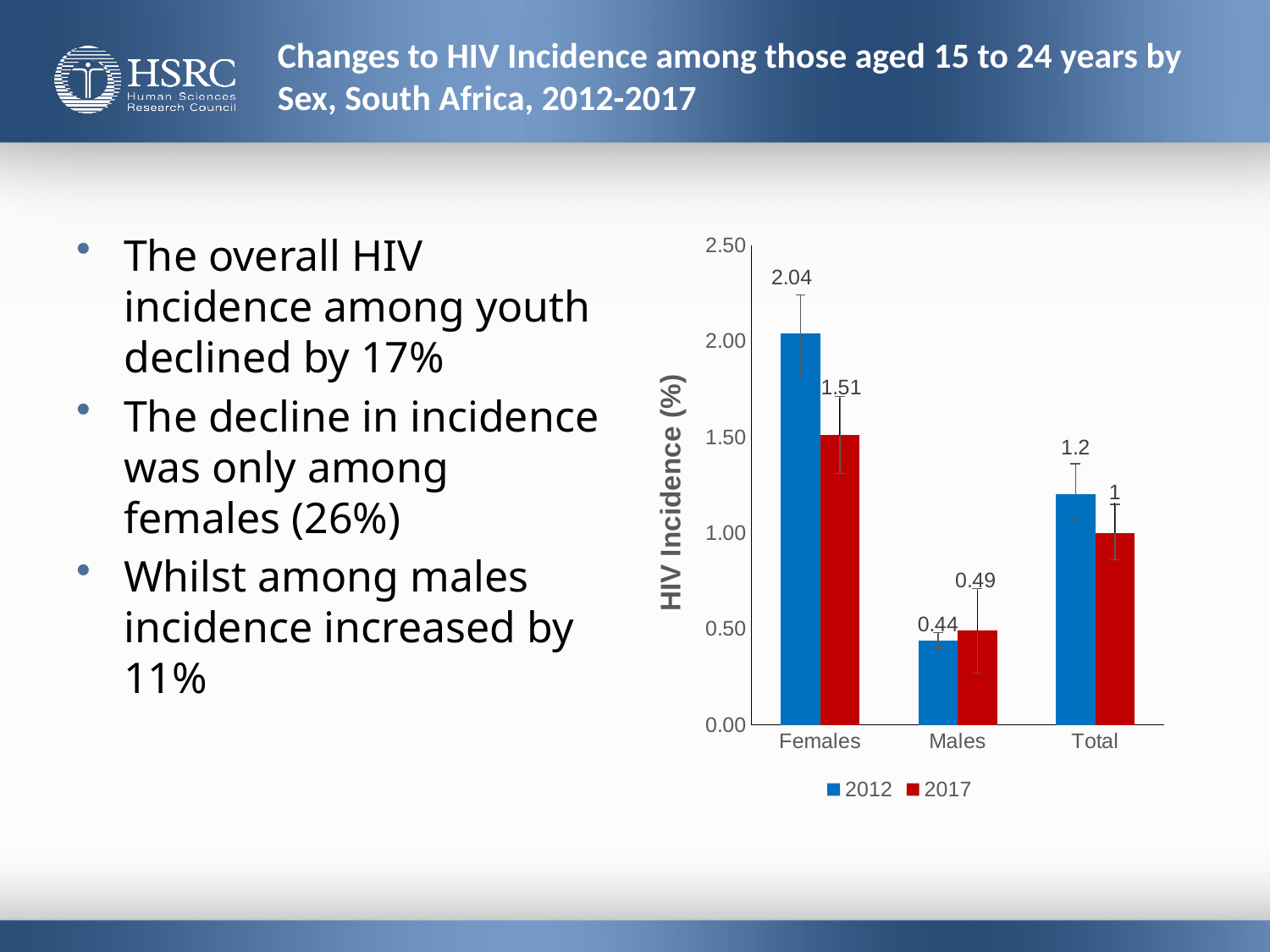
How many series does the legend list? 2 What is the difference between the 2012 and 2017 HIV incidence for Females? 0.53 Which is larger, the 2012 or the 2017 HIV incidence for Total? 2012 Is the 2017 HIV incidence for Females greater or less than 1.00? greater Which category has the highest HIV incidence in 2012? Females How many categories are shown on the x axis? 3 What is the label of the y axis? HIV Incidence (%) Which category has the lowest HIV incidence in 2017? Males What is the HIV incidence for Females in 2012? 2.04 What is the HIV incidence for Males in 2017? 0.49 What is the HIV incidence for Total in 2012? 1.2 What kind of chart is shown on the slide? bar chart